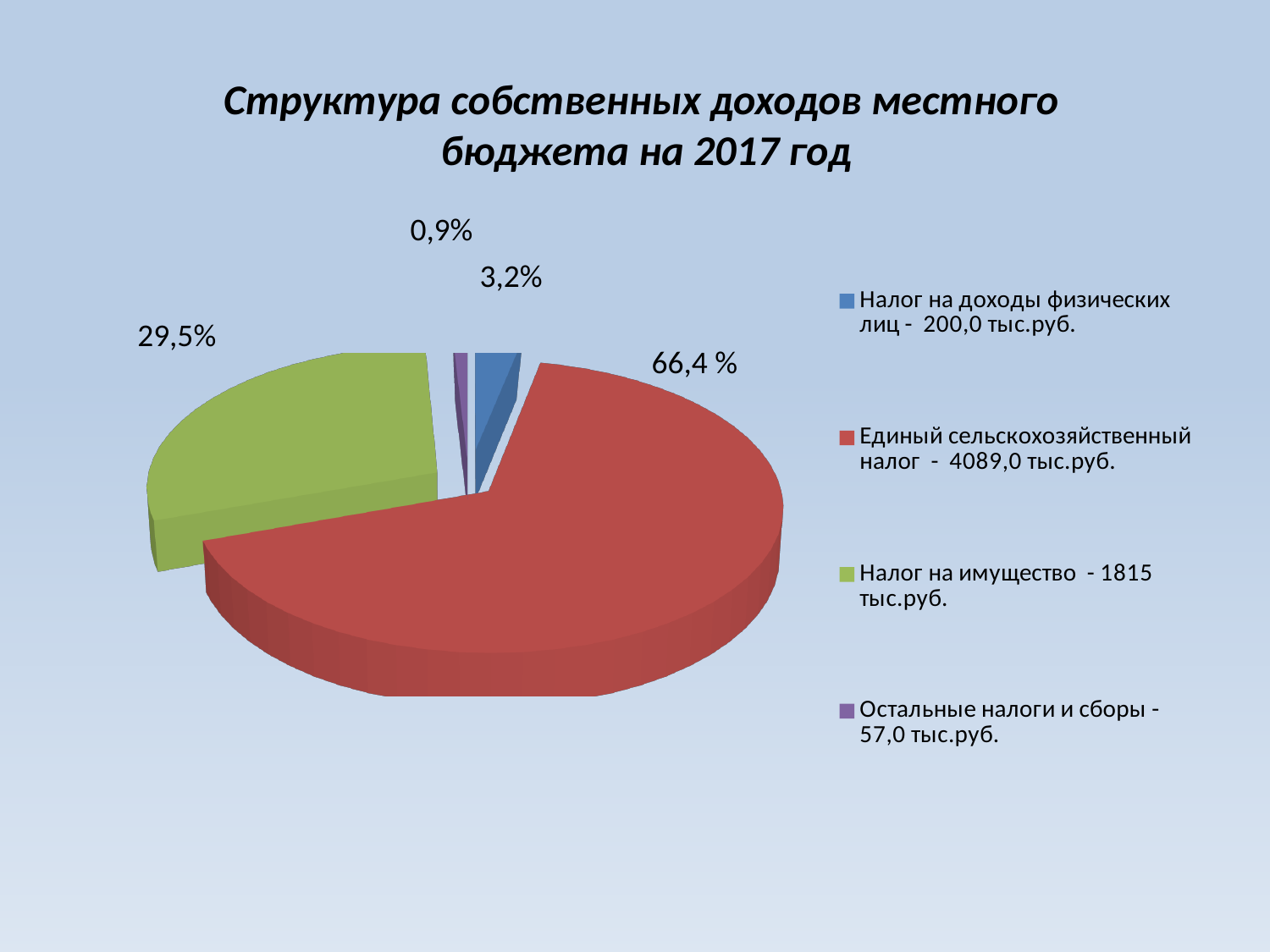
What is the difference in percentage points between the shares of Единый сельскохозяйственный налог and Налог на имущество? 36,9 What share of the pie does Единый сельскохозяйственный налог have? 66,4 % How many slices does the pie chart have? 4 What colour is the slice for Единый сельскохозяйственный налог? red Which category has the smallest slice of the pie? Остальные налоги и сборы Which category has the largest slice of the pie? Единый сельскохозяйственный налог What share of the pie does Налог на имущество have? 29,5% According to the legend, what amount in тыс.руб. is given for Налог на имущество? 1815 тыс.руб. What share of the pie does Остальные налоги и сборы have? 0,9% Which is larger: the share of Налог на имущество or the share of Налог на доходы физических лиц? Налог на имущество What kind of chart is shown on the slide? pie chart